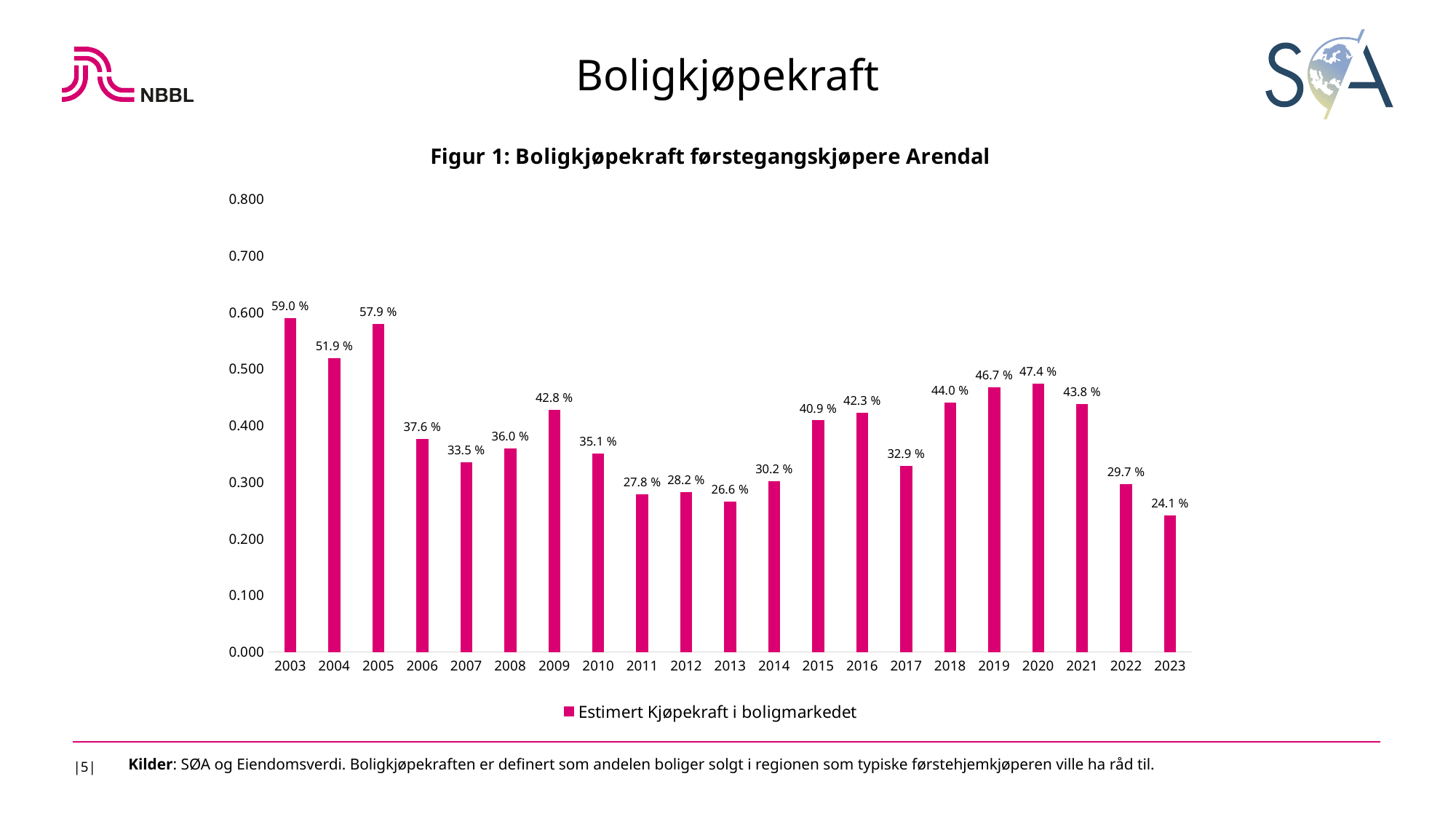
What is the difference between the values for 2020 and 2021? 3.6 % What kind of chart is shown? bar chart Is the value for 2019 greater or less than 0.400? greater Which year has the highest value? 2003 How many years are shown on the x axis? 21 Which is larger, the value for 2009 or the value for 2016? 2009 What is the legend entry for the series? Estimert Kjøpekraft i boligmarkedet Which year has the lowest value? 2023 What is the value for 2023? 24.1 % How many series does the legend list? 1 What is the value for 2013? 26.6 % What is the value for 2003? 59.0 %